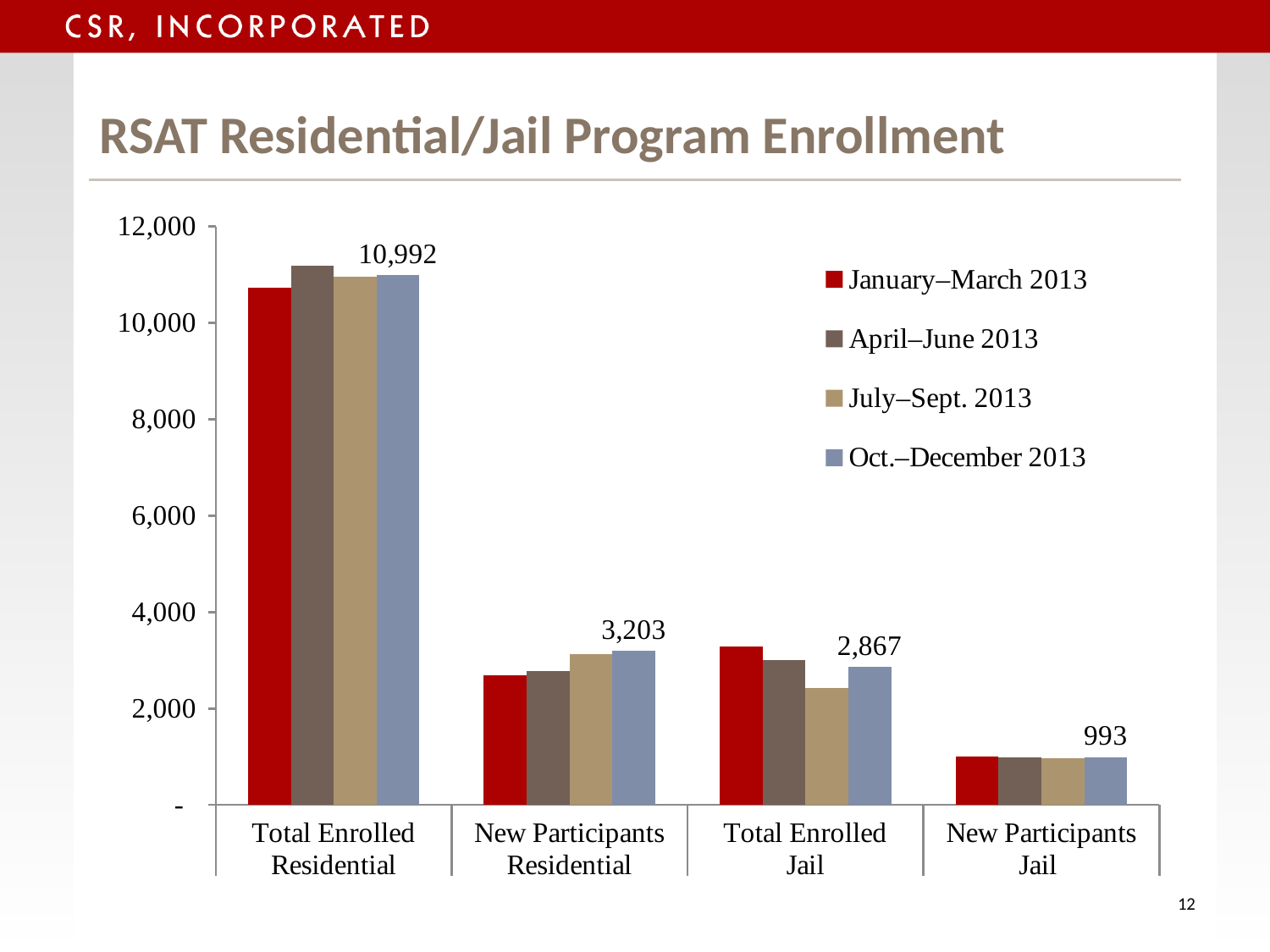
Is the July–Sept. 2013 value for Total Enrolled Jail greater or less than 4,000? less How many series does the legend list? 4 Across the four quarters, do the New Participants Residential values rise or fall? rise Is the January–March 2013 value for Total Enrolled Residential greater or less than 10,000? greater Which category has the highest enrollment values? Total Enrolled Residential Which category has the lowest enrollment values? New Participants Jail What is the difference between the Oct.–December 2013 values for Total Enrolled Jail and New Participants Jail? 1,874 What is the Oct.–December 2013 value for New Participants Residential? 3,203 What is the Oct.–December 2013 value for Total Enrolled Residential? 10,992 What is the difference between the Oct.–December 2013 values for Total Enrolled Residential and New Participants Residential? 7,789 What is the Oct.–December 2013 value for New Participants Jail? 993 What is the Oct.–December 2013 value for Total Enrolled Jail? 2,867